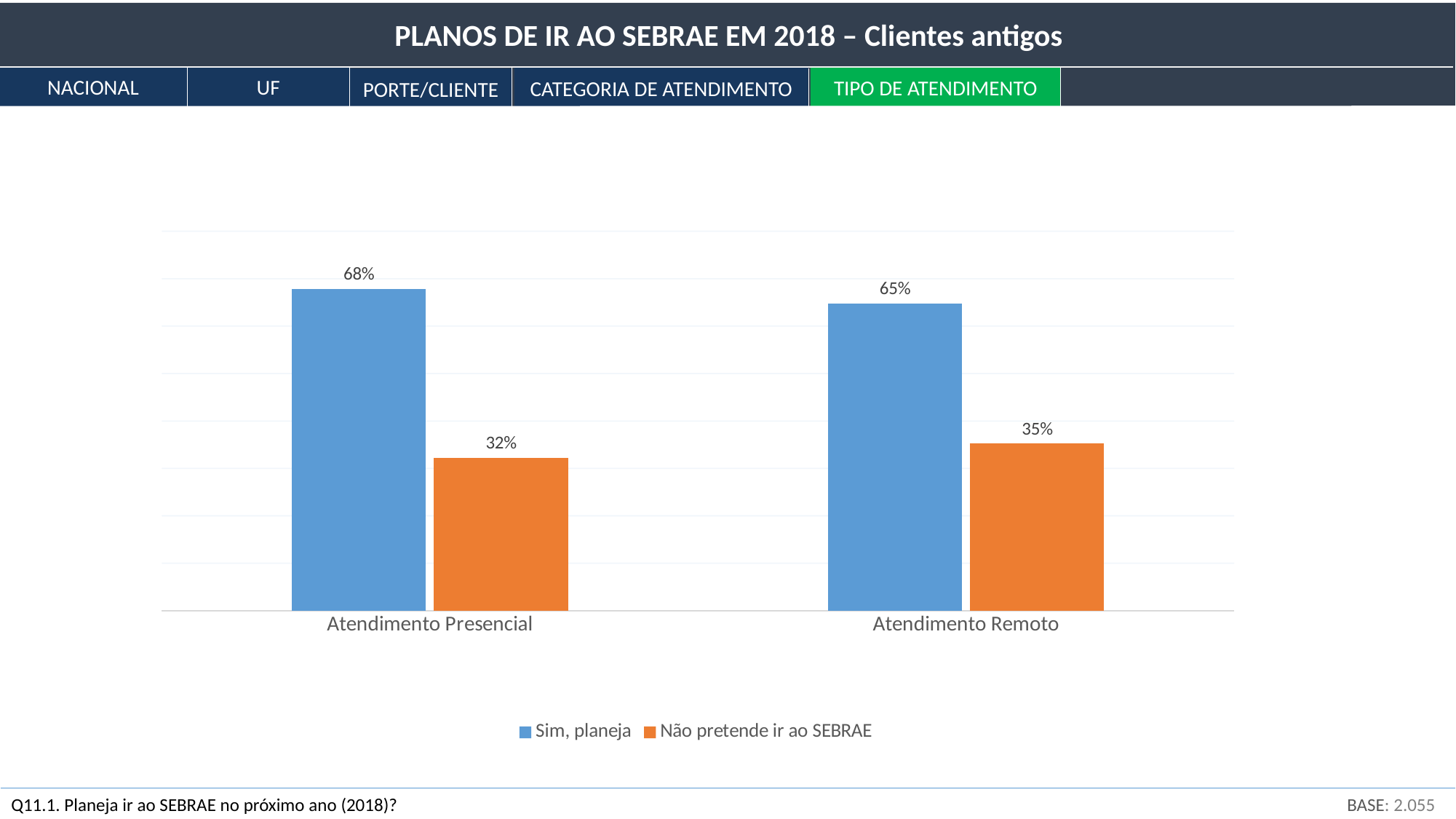
What is the value for "Sim, planeja" in the Atendimento Remoto category? 65% What is the value for "Não pretende ir ao SEBRAE" in the Atendimento Remoto category? 35% What is the difference between the "Sim, planeja" values for Atendimento Presencial and Atendimento Remoto? 3% Which colour represents the "Não pretende ir ao SEBRAE" series? Orange What is the value for "Sim, planeja" in the Atendimento Presencial category? 68% Which category has the highest value for "Sim, planeja"? Atendimento Presencial Which category has the lowest value for "Não pretende ir ao SEBRAE"? Atendimento Presencial What kind of chart is shown on the slide? Bar chart How many categories are shown on the x axis? 2 Which is larger in the Atendimento Remoto category: "Sim, planeja" or "Não pretende ir ao SEBRAE"? Sim, planeja What is the value for "Não pretende ir ao SEBRAE" in the Atendimento Presencial category? 32% How many series does the legend list? 2